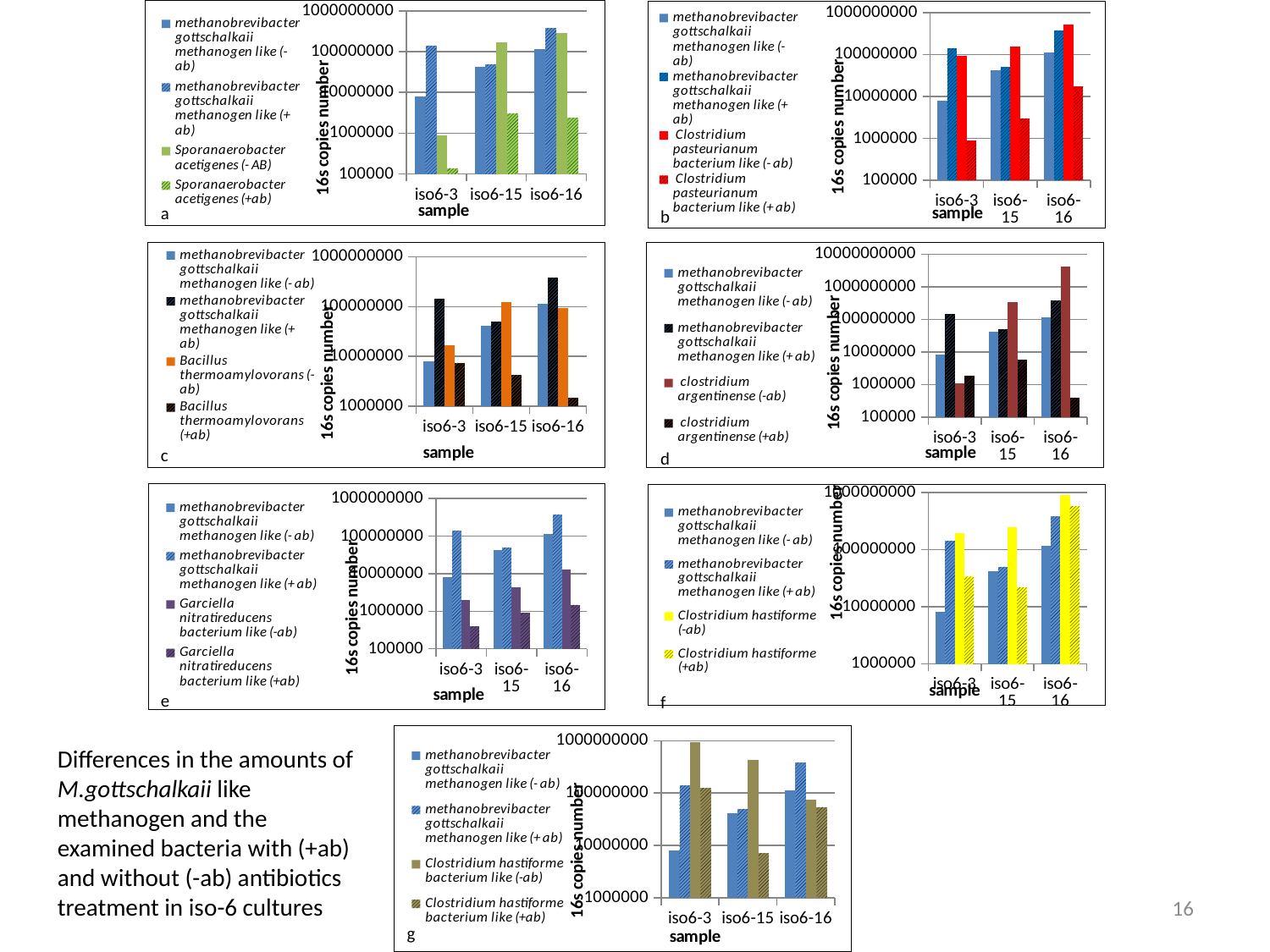
What is the label of the y axis in chart c? 16s copies number In chart a (top left), which sample has the lowest value for methanobrevibacter gottschalkaii methanogen like (-ab)? iso6-3 How many samples are shown on the x axis of chart g (bottom)? 3 In chart d at iso6-16, which is larger: clostridium argentinense (-ab) or clostridium argentinense (+ab)? clostridium argentinense (-ab) In chart a (top left), is the value for Sporanaerobacter acetigenes (+ab) at iso6-3 greater or less than 1000000? less In chart d, is the value for clostridium argentinense (-ab) at iso6-16 greater or less than 1000000000? greater How many series does the legend of chart b (top right) list? 4 In chart d, which sample has the highest value for clostridium argentinense (-ab)? iso6-16 In chart e, is the value for Garciella nitratireducens bacterium like (+ab) at iso6-3 greater or less than 1000000? less What kind of chart is chart a (top left)? bar chart